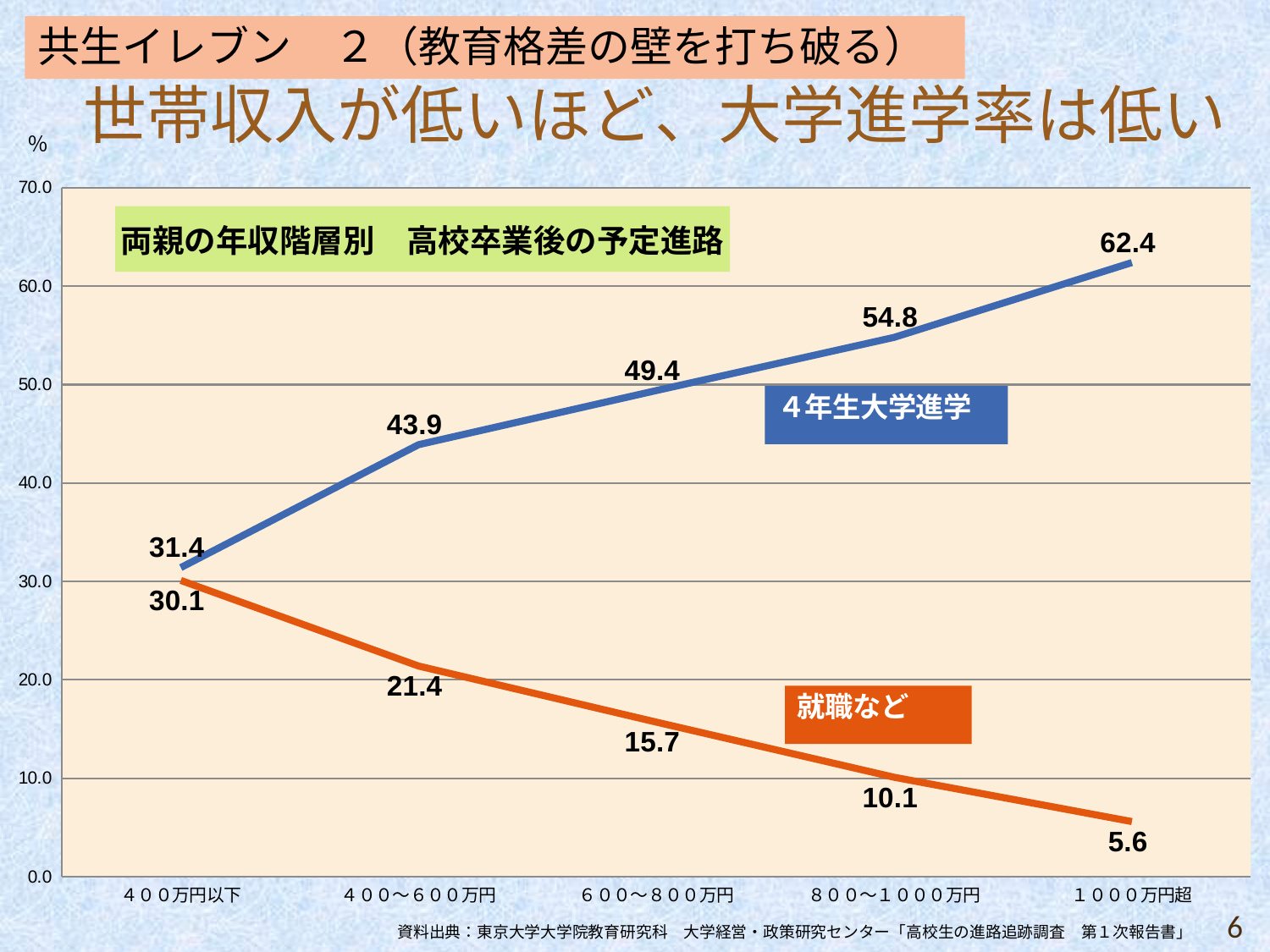
What is the value for ４年生大学進学 in the ４００万円以下 category? 31.4 In the ４００～６００万円 category, which is larger: ４年生大学進学 or 就職など? ４年生大学進学 What is the title shown inside the chart area? 両親の年収階層別 高校卒業後の予定進路 What is the value for 就職など in the １０００万円超 category? 5.6 What is the value for ４年生大学進学 in the ６００～８００万円 category? 49.4 How many income categories are shown on the x axis? 5 What is the difference between the ４年生大学進学 values for １０００万円超 and ４００万円以下? 31.0 What kind of chart is shown on the slide? Line chart How many series are plotted on the chart? 2 Which income category has the highest value for ４年生大学進学? １０００万円超 Does the 就職など series rise or fall as income increases along the x axis? Fall Which income category has the lowest value for 就職など? １０００万円超